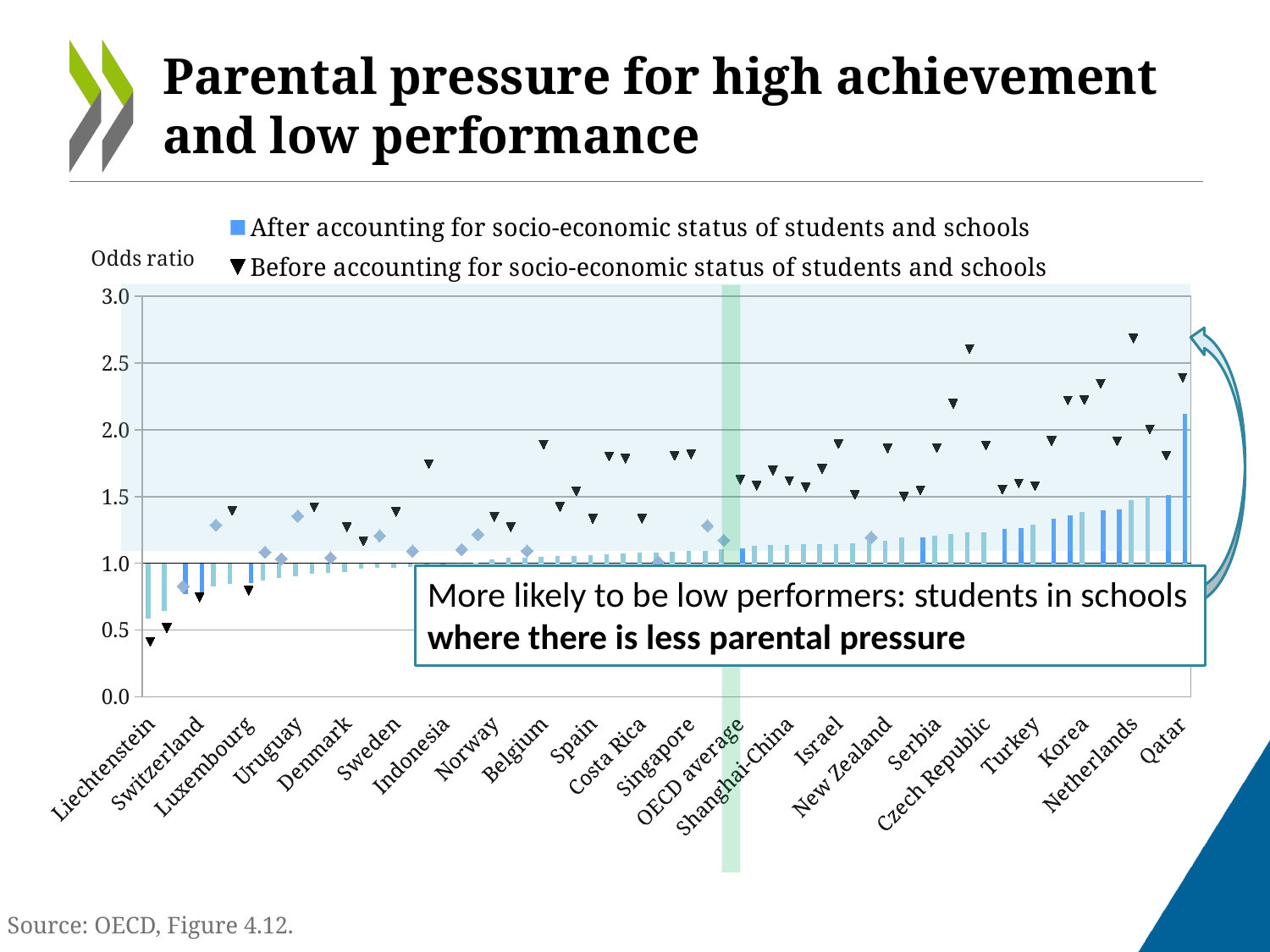
Is the 'After accounting for socio-economic status' bar for Qatar greater or less than 1.5? greater Which country has the lowest bar for 'After accounting for socio-economic status of students and schools'? Liechtenstein Which has the larger 'After accounting for socio-economic status' bar, Qatar or Liechtenstein? Qatar What is the label on the vertical axis of the chart? Odds ratio Which series in the legend is shown with a triangle marker? Before accounting for socio-economic status of students and schools Which country has the highest bar for 'After accounting for socio-economic status of students and schools'? Qatar Do the 'After accounting for socio-economic status' bars generally rise or fall from left to right across the chart? Rise Is the 'Before accounting for socio-economic status' value for Liechtenstein greater or less than 1.0? less What kind of chart is shown on the slide? Combination chart with bars and triangle markers Is the 'Before accounting for socio-economic status' value for Qatar greater or less than 2.0? greater How many series does the legend list? 2